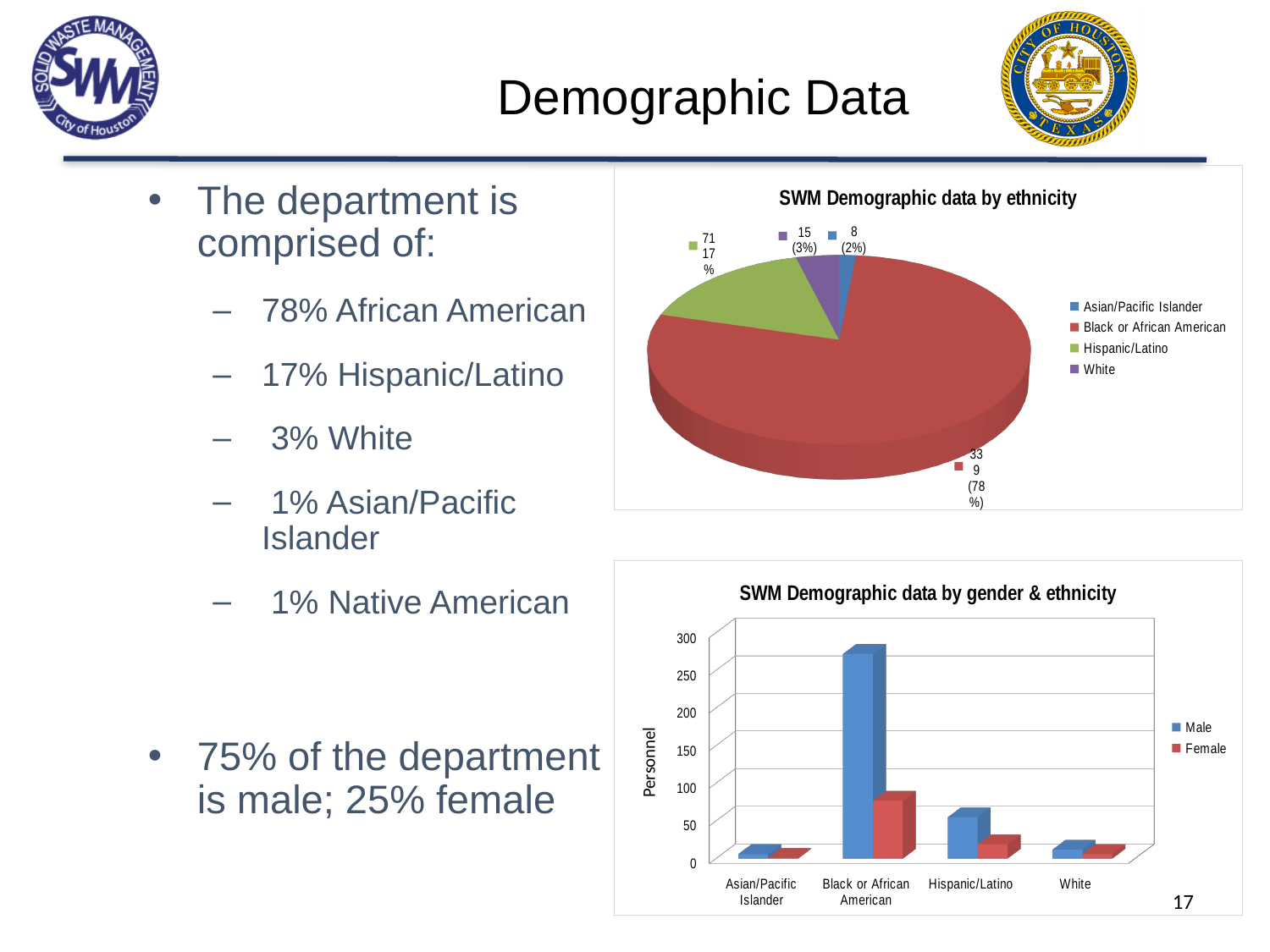
In the pie chart 'SWM Demographic data by ethnicity', how many ethnicity categories are listed in the legend? 4 In the bar chart 'SWM Demographic data by gender & ethnicity', is the Female value for Black or African American greater or less than 100? less In the pie chart 'SWM Demographic data by ethnicity', what percentage is shown for Black or African American? 78% In the pie chart 'SWM Demographic data by ethnicity', what value is shown for Hispanic/Latino? 71 In the bar chart 'SWM Demographic data by gender & ethnicity', how many series does the legend list? 2 In the bar chart 'SWM Demographic data by gender & ethnicity', is the Male value for Black or African American greater or less than 250? greater What type of chart is 'SWM Demographic data by gender & ethnicity'? Bar chart In the pie chart 'SWM Demographic data by ethnicity', which ethnicity has the smallest slice? Asian/Pacific Islander In the pie chart 'SWM Demographic data by ethnicity', what value and percentage are shown for Asian/Pacific Islander? 8 (2%) In the pie chart 'SWM Demographic data by ethnicity', which ethnicity has the largest slice? Black or African American In the pie chart 'SWM Demographic data by ethnicity', what value and percentage are shown for White? 15 (3%) In the bar chart 'SWM Demographic data by gender & ethnicity', which is larger for Hispanic/Latino, the Male value or the Female value? Male